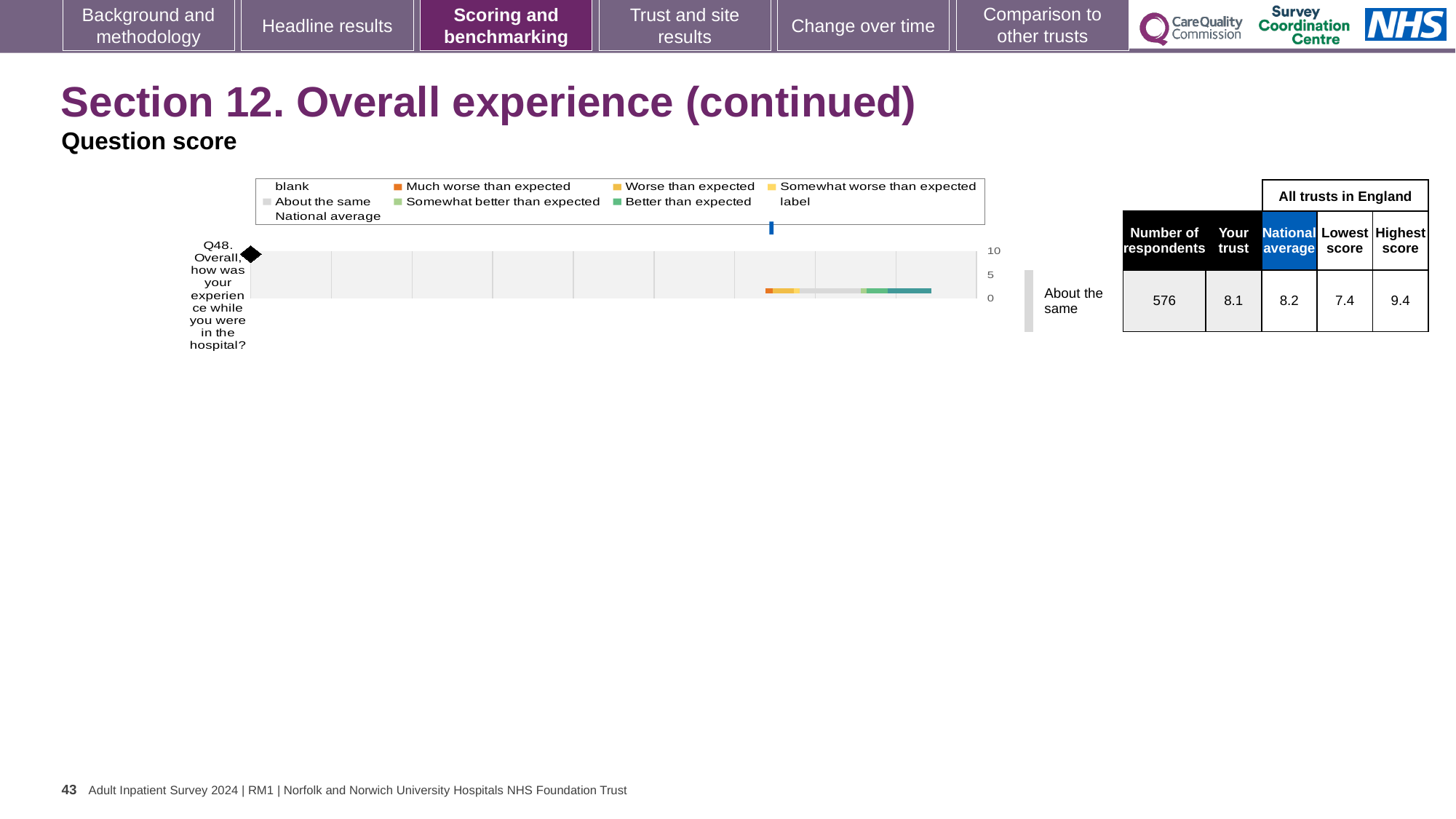
What is the lowest score among all trusts in England for Q48? 7.4 What is the national average score for Q48? 8.2 What kind of chart is used to show the Q48 question score? bar chart Which is larger for Q48, the 'Your trust' score or the national average? National average What benchmark category is shown next to the Q48 bar? About the same Is the national average marker for Q48 greater or less than 5 on the chart's axis? greater What is the 'Your trust' score for Q48? 8.1 What is the number of respondents for Q48? 576 By how much does the national average exceed the 'Your trust' score for Q48? 0.1 How many questions are plotted on the chart? 1 What is the difference between the highest score and the lowest score for Q48? 2.0 What is the highest score among all trusts in England for Q48? 9.4